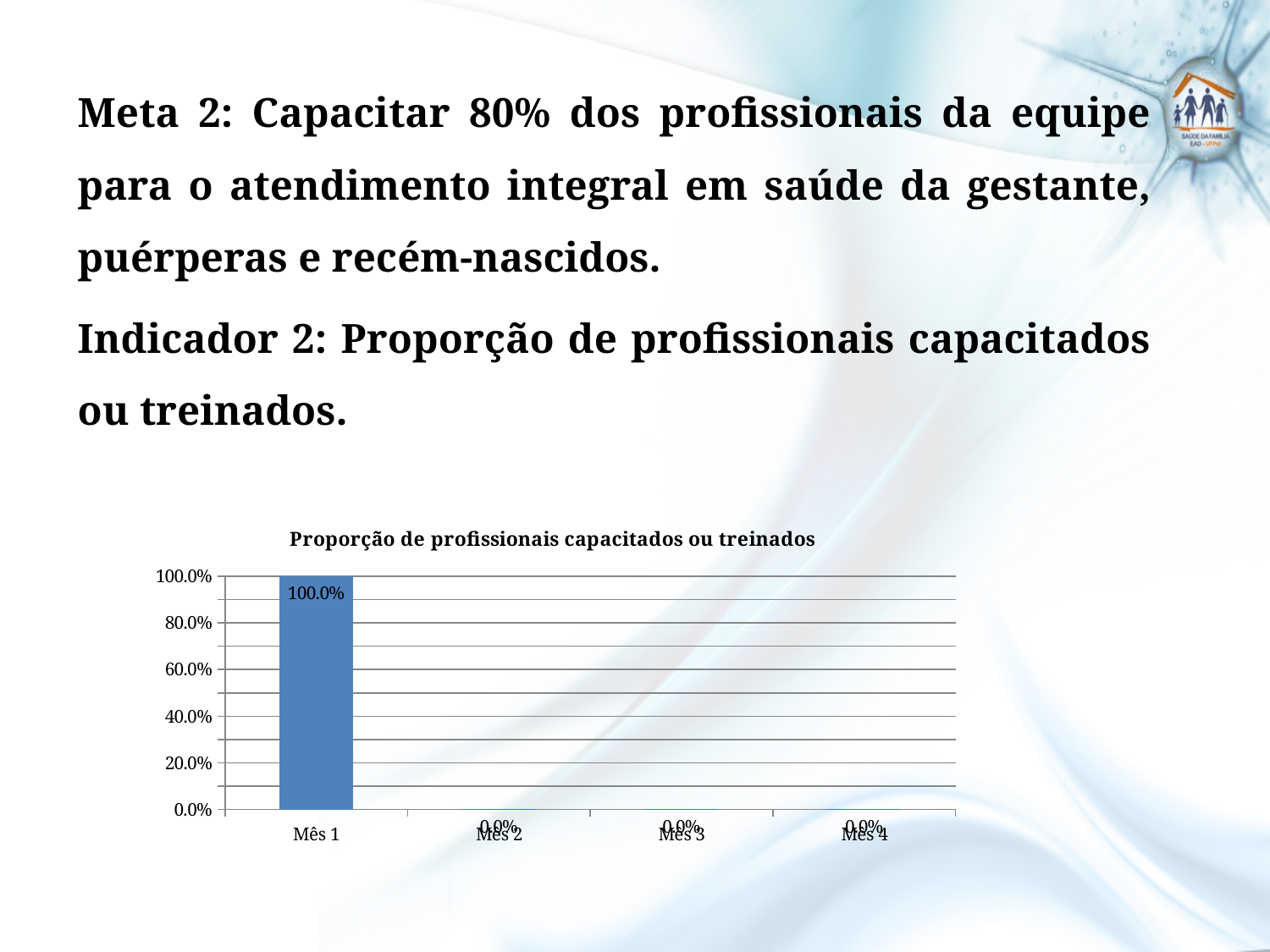
How many months are shown on the x axis? 4 Which month has the highest value? Mês 1 What is the difference between the values for Mês 1 and Mês 3? 100.0% What is the highest value shown on the y axis? 100.0% What is the value for Mês 1? 100.0% Do the values rise or fall from Mês 1 to Mês 2? fall Is the value for Mês 1 greater or less than 80.0%? greater What is the title of the chart? Proporção de profissionais capacitados ou treinados Which is larger, the value for Mês 1 or the value for Mês 2? Mês 1 What kind of chart is shown? bar chart What is the value for Mês 2? 0.0% What is the value for Mês 4? 0.0%